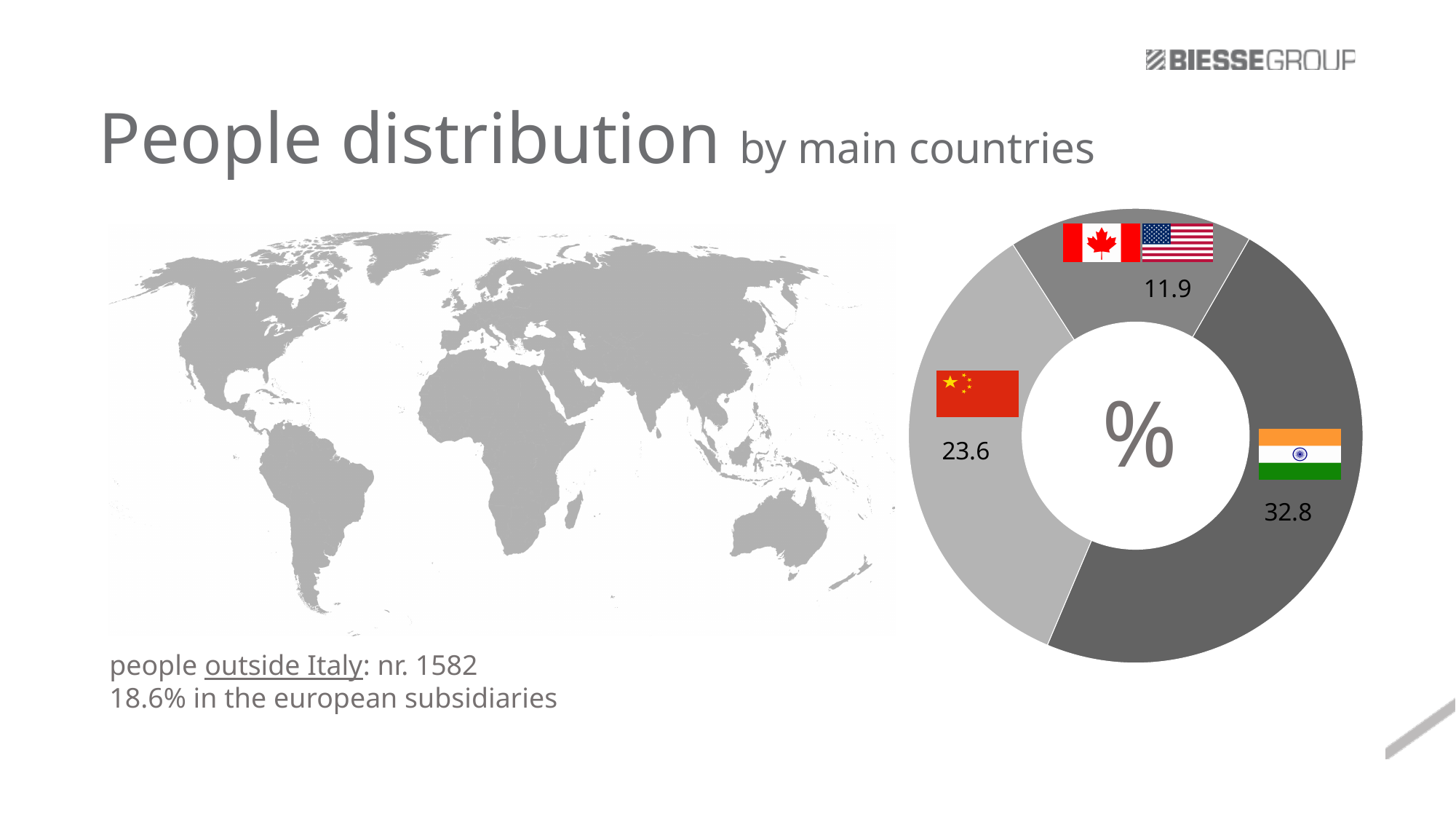
What kind of chart is shown on the slide? donut chart What value is shown for the slice marked with the Chinese flag? 23.6 How many labelled values are printed on the donut chart? 3 What value is shown for the slice marked with the Canadian and US flags? 11.9 What symbol is displayed in the centre of the donut chart? % Which is larger, the value for China or the value for Canada/USA? China Which country's slice has the highest labelled value in the donut chart? India What is the difference between the India value and the Canada/USA value? 20.9 What is the difference between the India value and the China value? 9.2 What value is shown for the slice marked with the Indian flag? 32.8 What is the difference between the China value and the Canada/USA value? 11.7 Which slice has the lowest labelled value in the donut chart? Canada and USA